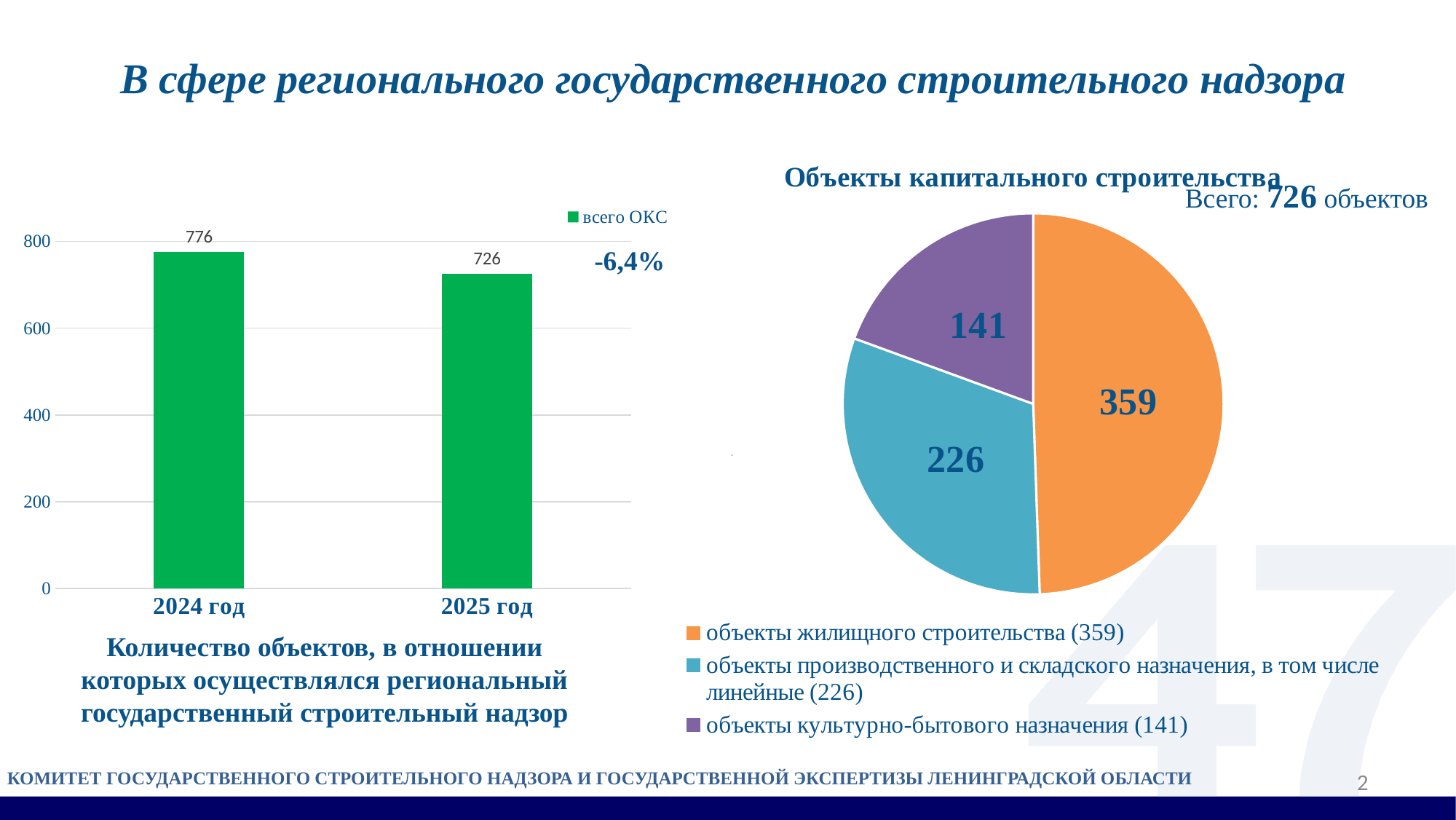
What is the total number of objects shown for the pie chart 'Объекты капитального строительства'? 726 In the bar chart on the left, which year has the higher value, 2024 год or 2025 год? 2024 год In the bar chart on the left, what is the value for 2024 год? 776 In the pie chart 'Объекты капитального строительства', which category has the smallest value? объекты культурно-бытового назначения How many slices does the pie chart 'Объекты капитального строительства' have? 3 In the bar chart on the left, what is the difference between the values for 2024 год and 2025 год? 50 In the pie chart 'Объекты капитального строительства', what is the difference between объекты жилищного строительства and объекты производственного и складского назначения? 133 In the bar chart on the left, what series name does the legend show? всего ОКС In the pie chart 'Объекты капитального строительства', what is the value for объекты жилищного строительства? 359 What kind of chart is the chart on the left of the slide? bar chart In the bar chart on the left, do the values rise or fall from 2024 год to 2025 год? fall In the bar chart on the left, what is the value for 2025 год? 726